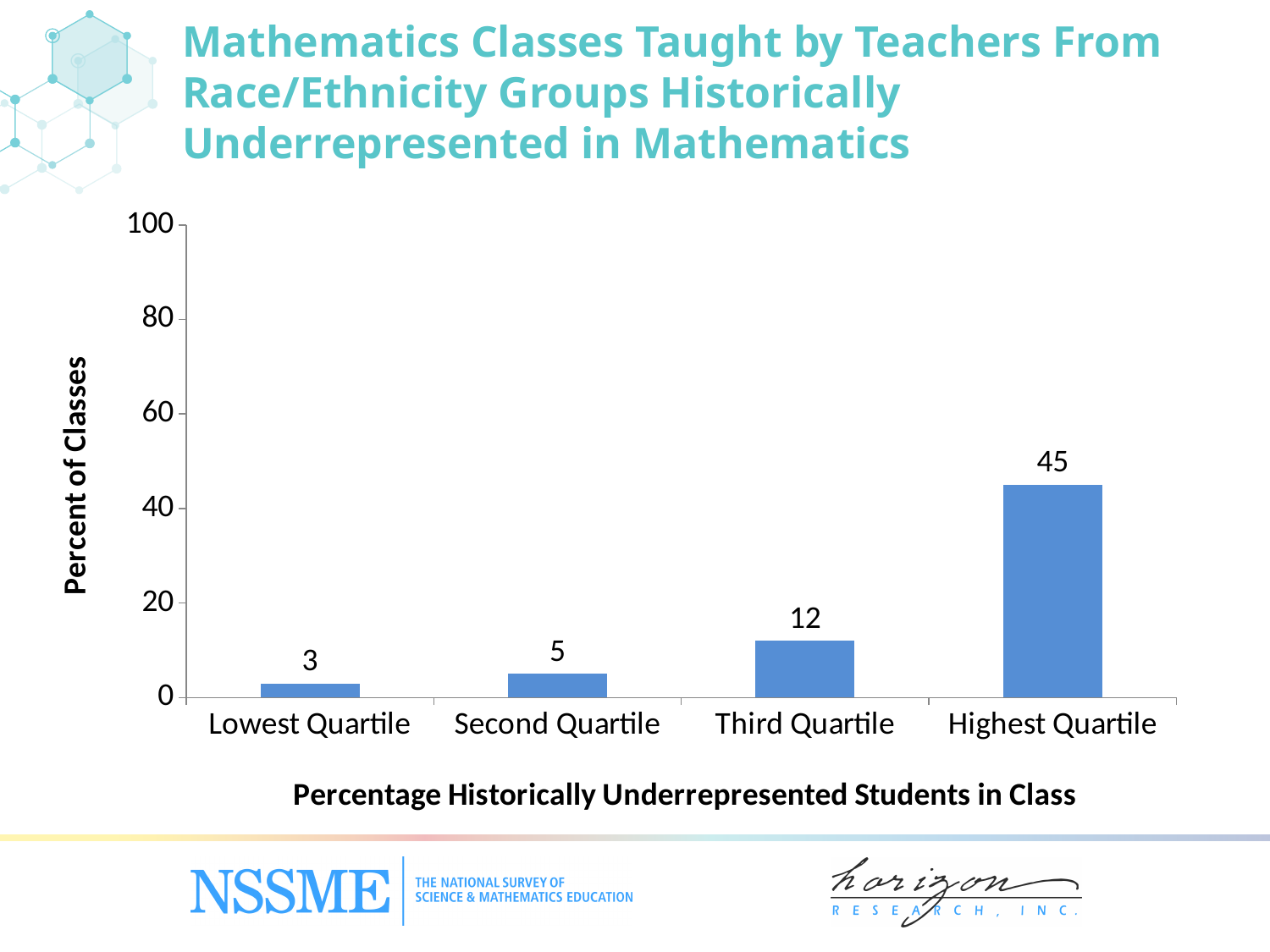
What is the value for Second Quartile? 5 Which category has the lowest percent of classes? Lowest Quartile What is the value for Highest Quartile? 45 Do the values rise or fall from Lowest Quartile to Highest Quartile? rise What is the value for Lowest Quartile? 3 What is the difference between the values for Highest Quartile and Third Quartile? 33 How many categories are shown on the x axis? 4 Is the value for Highest Quartile greater or less than 40? greater What kind of chart is shown on the slide? bar chart Which category has the highest percent of classes? Highest Quartile Which is larger, the value for Second Quartile or the value for Third Quartile? Third Quartile What is the value for Third Quartile? 12